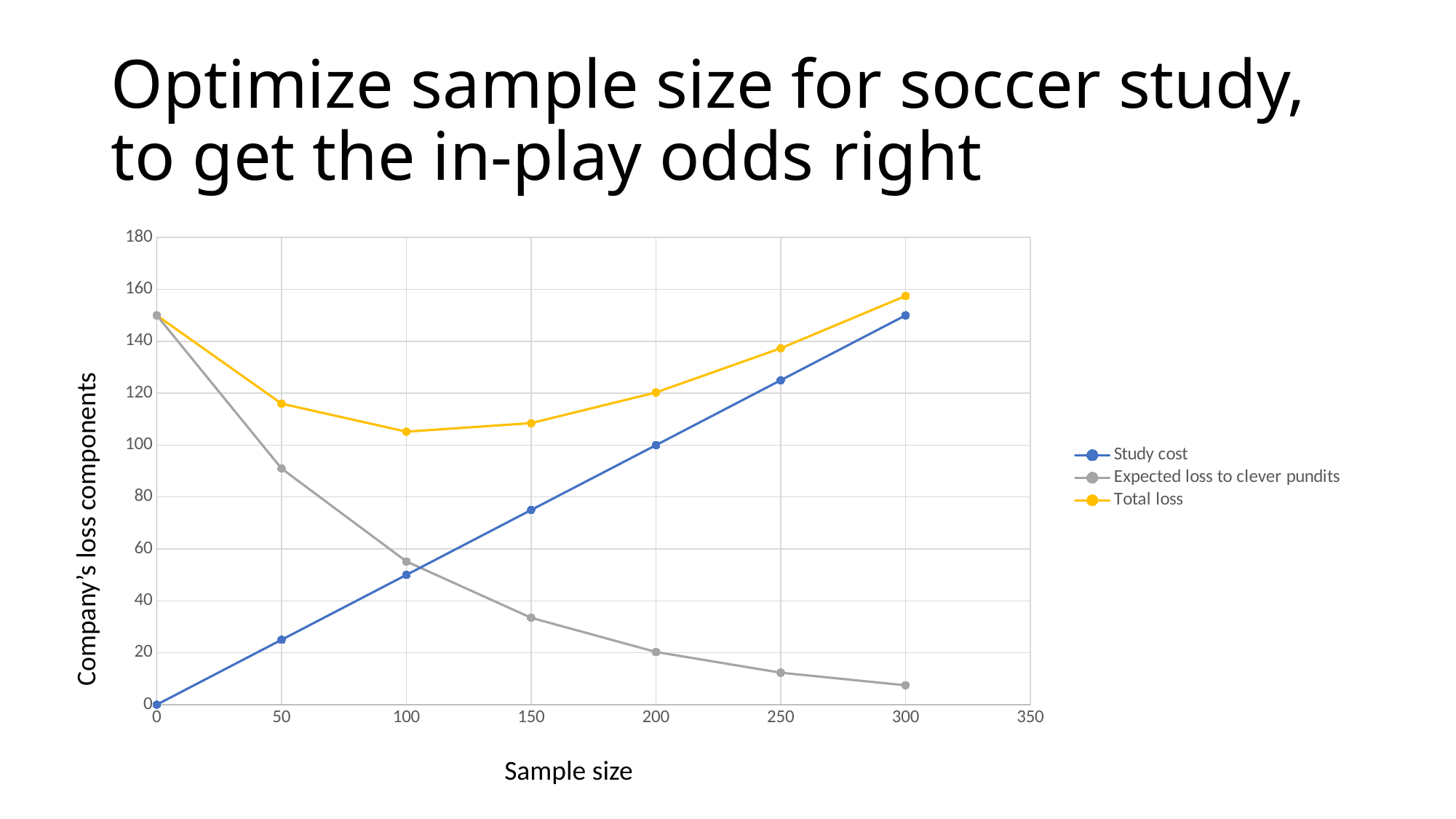
Does the Study cost rise or fall as the sample size increases? rises At which sample size is the Total loss highest? 300 What kind of chart is shown on the slide? line chart How many series does the legend list? 3 Is the Expected loss to clever pundits at a sample size of 300 greater or less than 20? less Is the Total loss at a sample size of 100 greater or less than 100? greater At which sample size is the Total loss lowest? 100 At a sample size of 150, which is larger: Study cost or Expected loss to clever pundits? Study cost